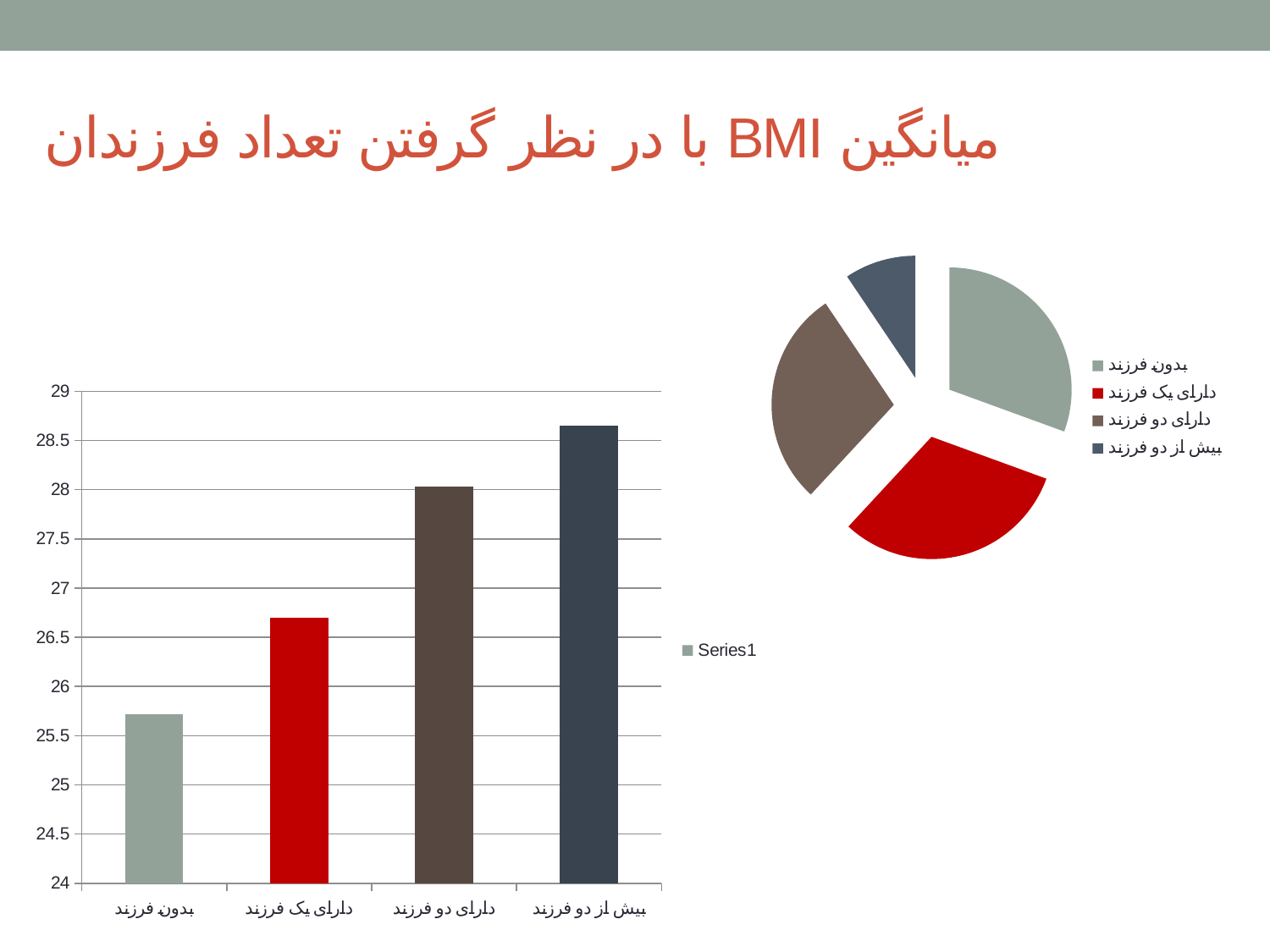
What kind of chart is the chart on the left of the slide? bar chart In the bar chart on the left, is the value for بدون فرزند greater or less than 26? less In the bar chart on the left, do the values rise or fall from left to right along the x axis? rise In the bar chart on the left, how many series does the legend list? 1 In the bar chart on the left, is the value for بیش از دو فرزند greater or less than 28? greater In the bar chart on the left, which category has the lowest bar? بدون فرزند What kind of chart is the chart on the right of the slide? pie chart In the pie chart on the right, how many slices are there? 4 In the bar chart on the left, how many categories are shown on the x axis? 4 In the bar chart on the left, is the value for دارای یک فرزند greater or less than 27? less In the bar chart on the left, which category has the highest bar? بیش از دو فرزند In the bar chart on the left, which is larger, the value for دارای دو فرزند or the value for دارای یک فرزند? دارای دو فرزند